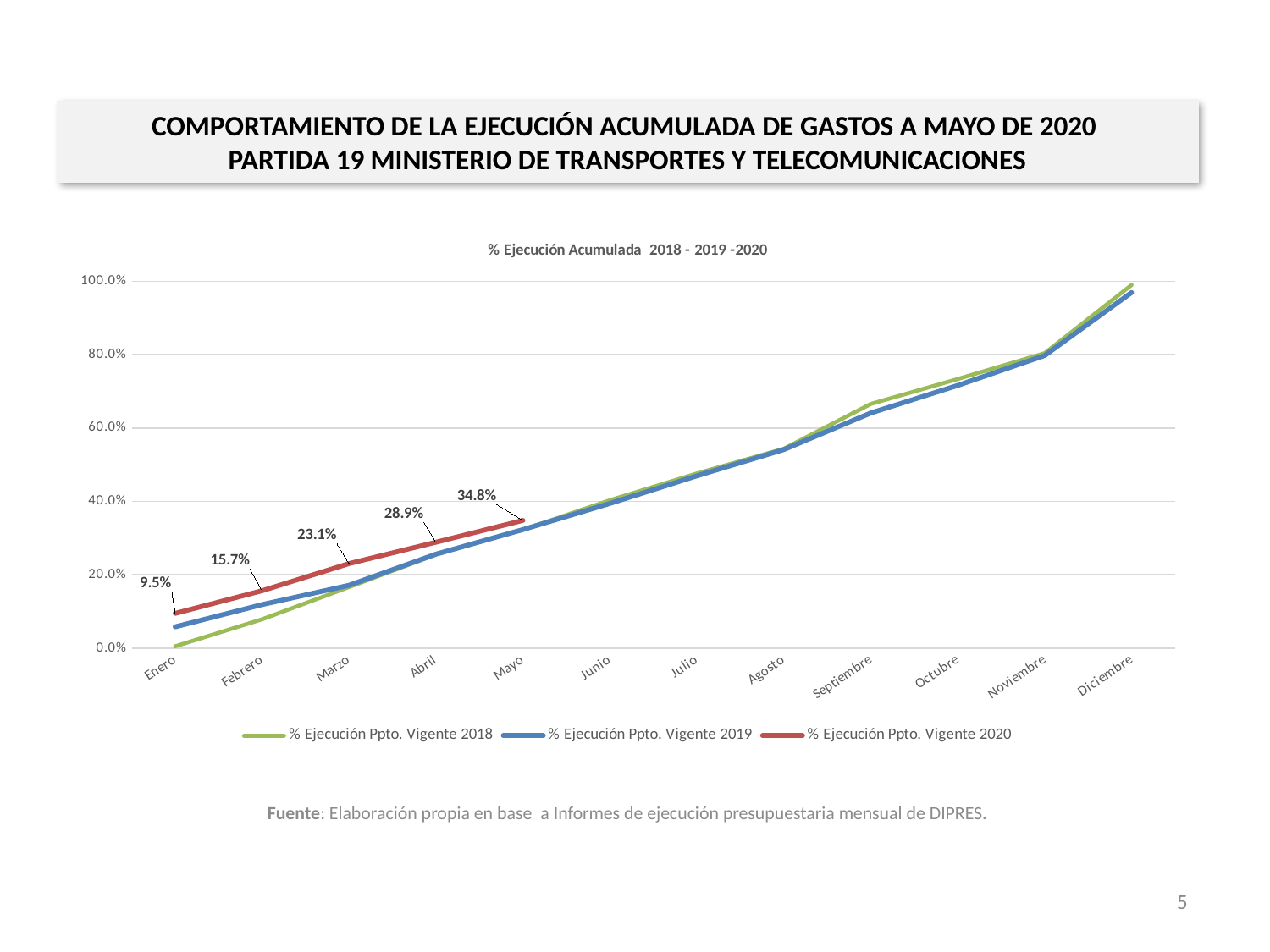
Is the value for Diciembre in the % Ejecución Ppto. Vigente 2018 series greater or less than 80.0%? greater How many series does the legend list? 3 What is the value for Mayo in the % Ejecución Ppto. Vigente 2020 series? 34.8% What is the difference between the Febrero and Enero values in the % Ejecución Ppto. Vigente 2020 series? 6.2% What is the value for Enero in the % Ejecución Ppto. Vigente 2020 series? 9.5% Is the value for Enero in the % Ejecución Ppto. Vigente 2019 series greater or less than 20.0%? less What is the value for Abril in the % Ejecución Ppto. Vigente 2020 series? 28.9% What is the value for Marzo in the % Ejecución Ppto. Vigente 2020 series? 23.1% Which month has the highest value in the % Ejecución Ppto. Vigente 2020 series? Mayo How many months are shown on the x axis? 12 What kind of chart is shown on the slide? Line chart What is the difference between the Mayo and Enero values in the % Ejecución Ppto. Vigente 2020 series? 25.3%